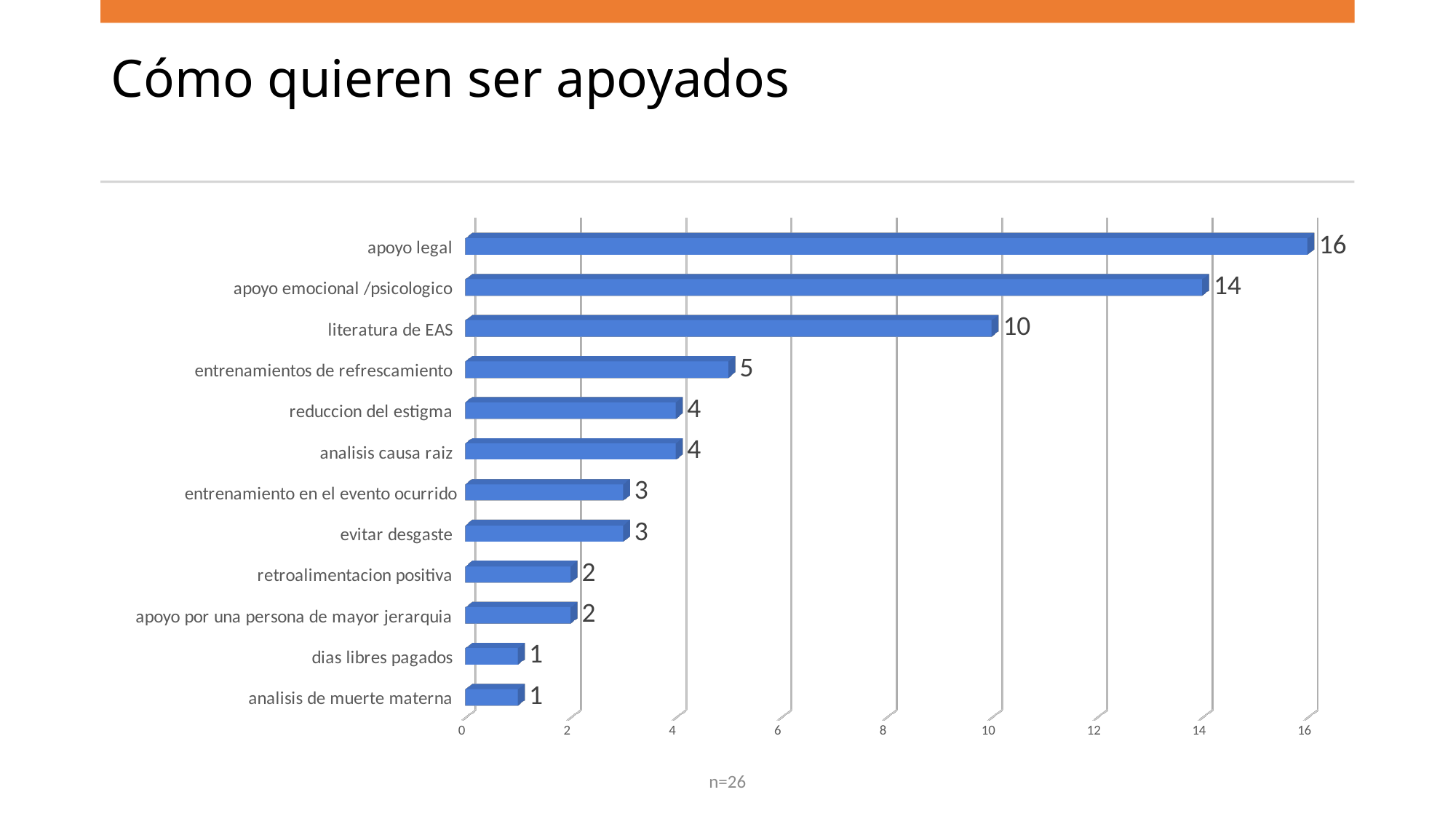
What is the value for entrenamientos de refrescamiento? 5 Which category has the highest value? apoyo legal Which is larger, the value for reduccion del estigma or the value for evitar desgaste? reduccion del estigma What is the value for literatura de EAS? 10 What is the value for apoyo legal? 16 Is the value for apoyo emocional /psicologico greater or less than 12? greater What is the difference between the values for apoyo legal and apoyo emocional /psicologico? 2 How many categories are shown in the chart? 12 What is the difference between the values for literatura de EAS and entrenamientos de refrescamiento? 5 What is the value for dias libres pagados? 1 What kind of chart is shown on the slide? bar chart What is the title of the slide? Cómo quieren ser apoyados